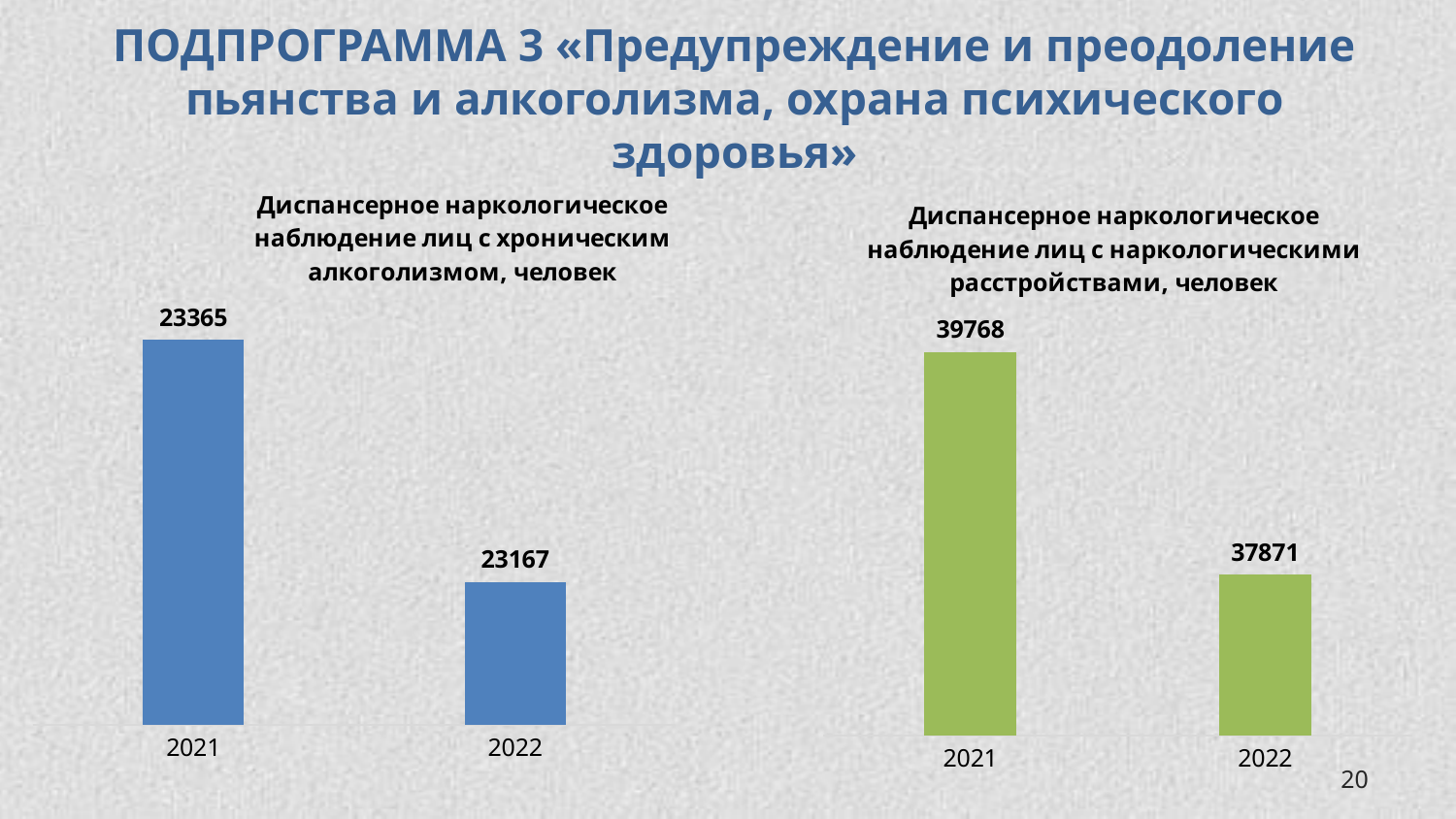
In the right chart (narcological disorders dispensary observation), is the value for 2021 larger or smaller than the value for 2022? larger What type of chart is the right chart (narcological disorders dispensary observation)? bar chart In the left chart (chronic alcoholism dispensary observation), do the values rise or fall from 2021 to 2022? fall In the left chart (chronic alcoholism dispensary observation), what is the difference between the 2021 and 2022 values? 198 In the right chart (narcological disorders dispensary observation), what is the value for 2022? 37871 In the left chart (chronic alcoholism dispensary observation), what is the value for 2021? 23365 How many bars are shown in the left chart (chronic alcoholism dispensary observation)? 2 In the left chart (chronic alcoholism dispensary observation), what is the value for 2022? 23167 In the right chart (narcological disorders dispensary observation), what is the difference between the 2021 and 2022 values? 1897 In the left chart (chronic alcoholism dispensary observation), which year has the higher value? 2021 In the right chart (narcological disorders dispensary observation), what is the value for 2021? 39768 In the right chart (narcological disorders dispensary observation), which year has the lower value? 2022